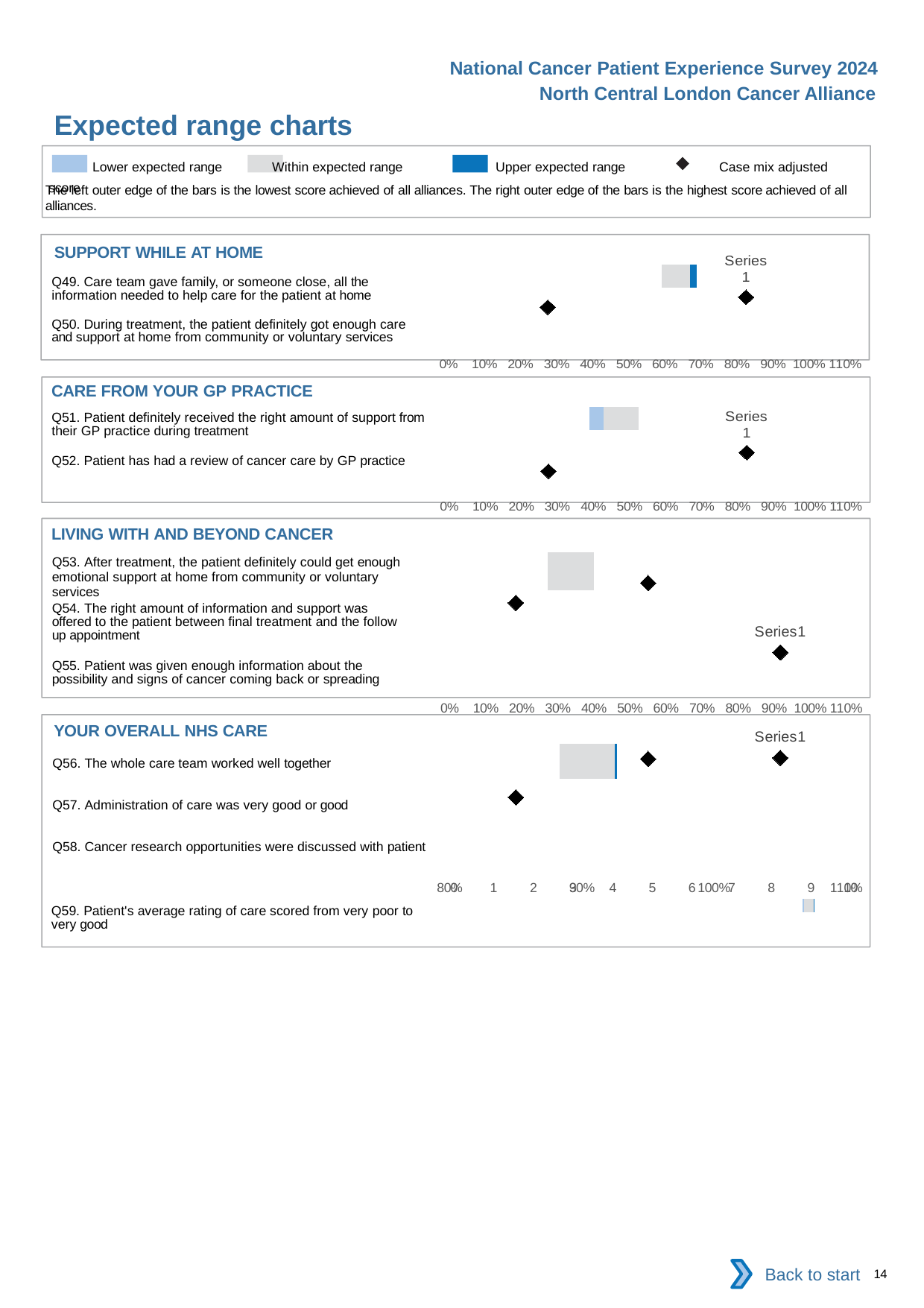
How many questions (categories) are listed in the LIVING WITH AND BEYOND CANCER chart? 3 What kind of chart is used in the SUPPORT WHILE AT HOME section? bar chart What is the title of the slide containing these charts? Expected range charts How many questions (categories) are listed in the SUPPORT WHILE AT HOME chart? 2 What is the highest tick label shown on the x axis of the SUPPORT WHILE AT HOME chart? 110% How many questions (categories) are listed in the YOUR OVERALL NHS CARE chart? 4 In the LIVING WITH AND BEYOND CANCER chart, is the leftmost diamond marker greater or less than 30%? less How many entries does the legend at the top of the slide list? 4 In the LIVING WITH AND BEYOND CANCER chart, is the rightmost diamond marker greater or less than 80%? greater